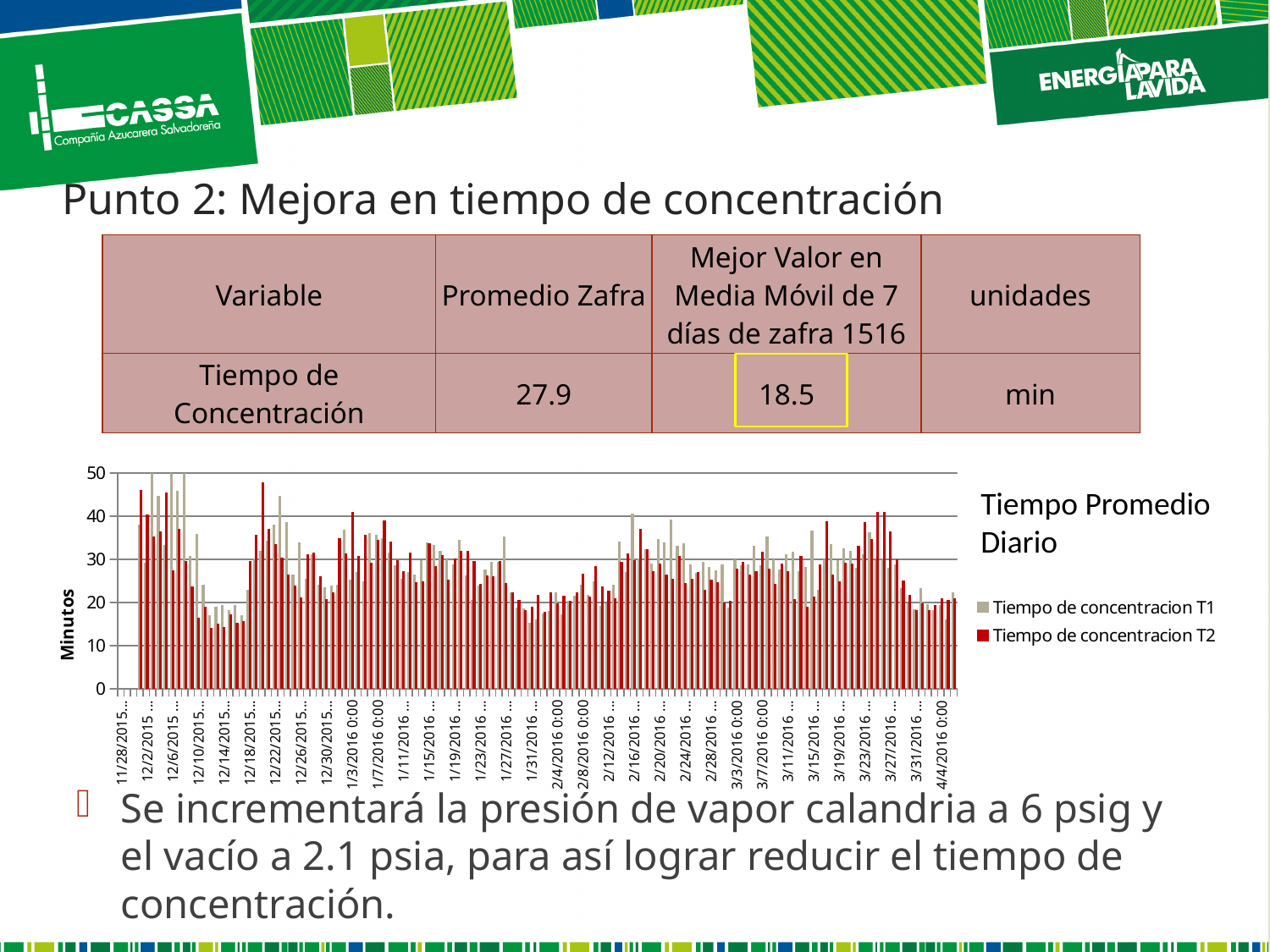
In the 'Tiempo Promedio Diario' chart, do the values generally rise or fall from 11/28/2015 to 4/4/2016? fall In the 'Tiempo Promedio Diario' chart, is the value for Tiempo de concentracion T2 at 1/31/2016 greater or less than 30? less How many series does the legend of the 'Tiempo Promedio Diario' chart list? 2 What is the label of the vertical axis of the 'Tiempo Promedio Diario' chart? Minutos What kind of chart is the 'Tiempo Promedio Diario' chart? bar chart In the 'Tiempo Promedio Diario' chart, is the value for Tiempo de concentracion T2 at 12/14/2015 greater or less than 20? less In the 'Tiempo Promedio Diario' chart, do the Tiempo de concentracion T2 values rise or fall between 12/2/2015 and 12/14/2015? fall In the 'Tiempo Promedio Diario' chart, which is larger: the Tiempo de concentracion T2 value at 12/2/2015 or at 12/14/2015? 12/2/2015 In the 'Tiempo Promedio Diario' chart, is the value for Tiempo de concentracion T1 at 12/2/2015 greater or less than 40? less What is the title of the chart on the slide? Tiempo Promedio Diario